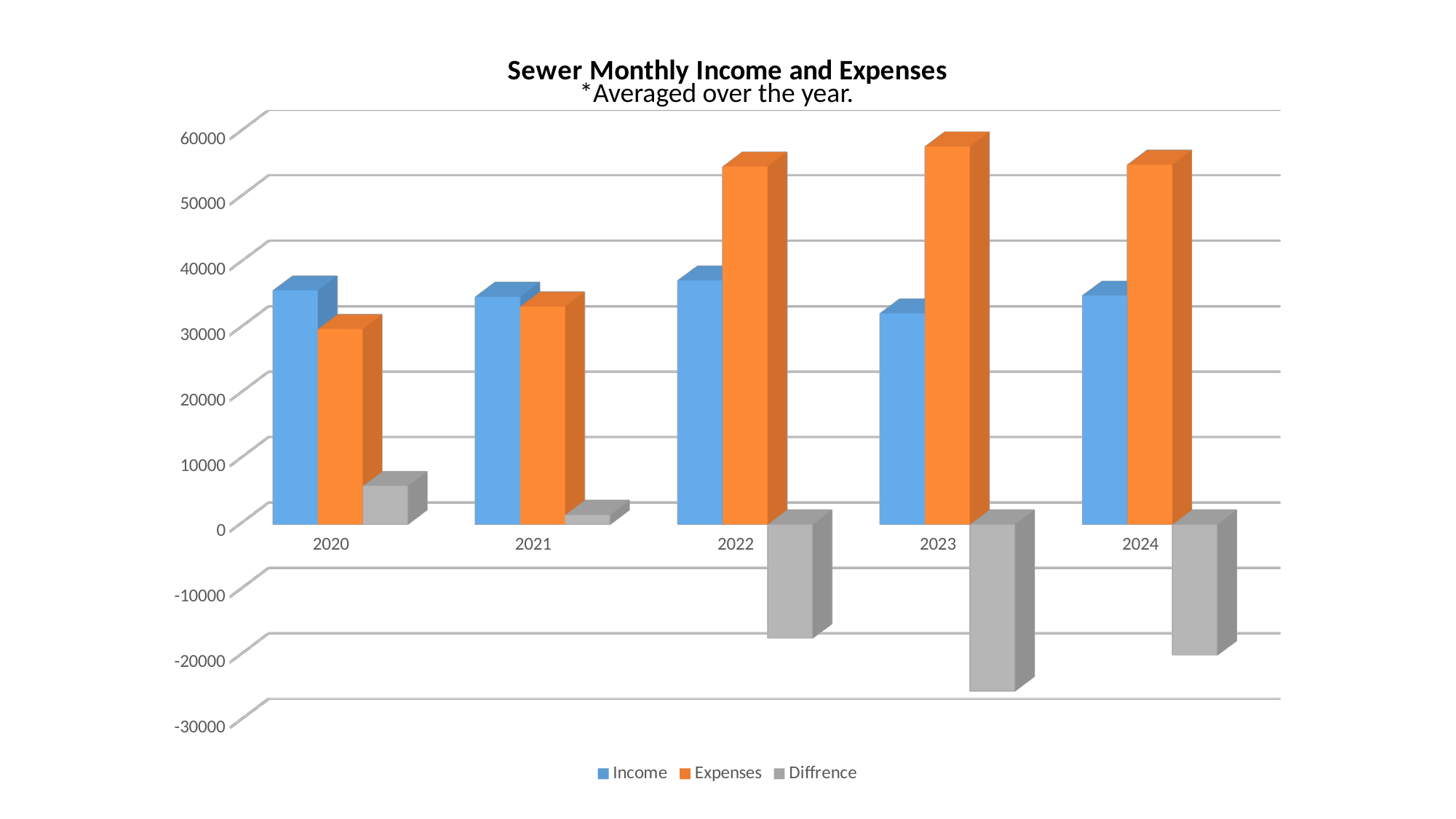
Is the value for Diffrence in 2023 greater or less than -20000? less In 2020, which is larger, Income or Expenses? Income Do Expenses rise or fall from 2020 to 2023? rise Is the value for Expenses in 2022 greater or less than 50000? greater Is the value for Income in 2020 greater or less than 40000? less How many years are shown on the x axis? 5 Which year has the lowest Expenses? 2020 Which year has the lowest Diffrence value? 2023 How many series does the legend list? 3 In 2023, which is larger, Income or Expenses? Expenses What kind of chart is shown on the slide? bar chart Which year has the highest Expenses? 2023